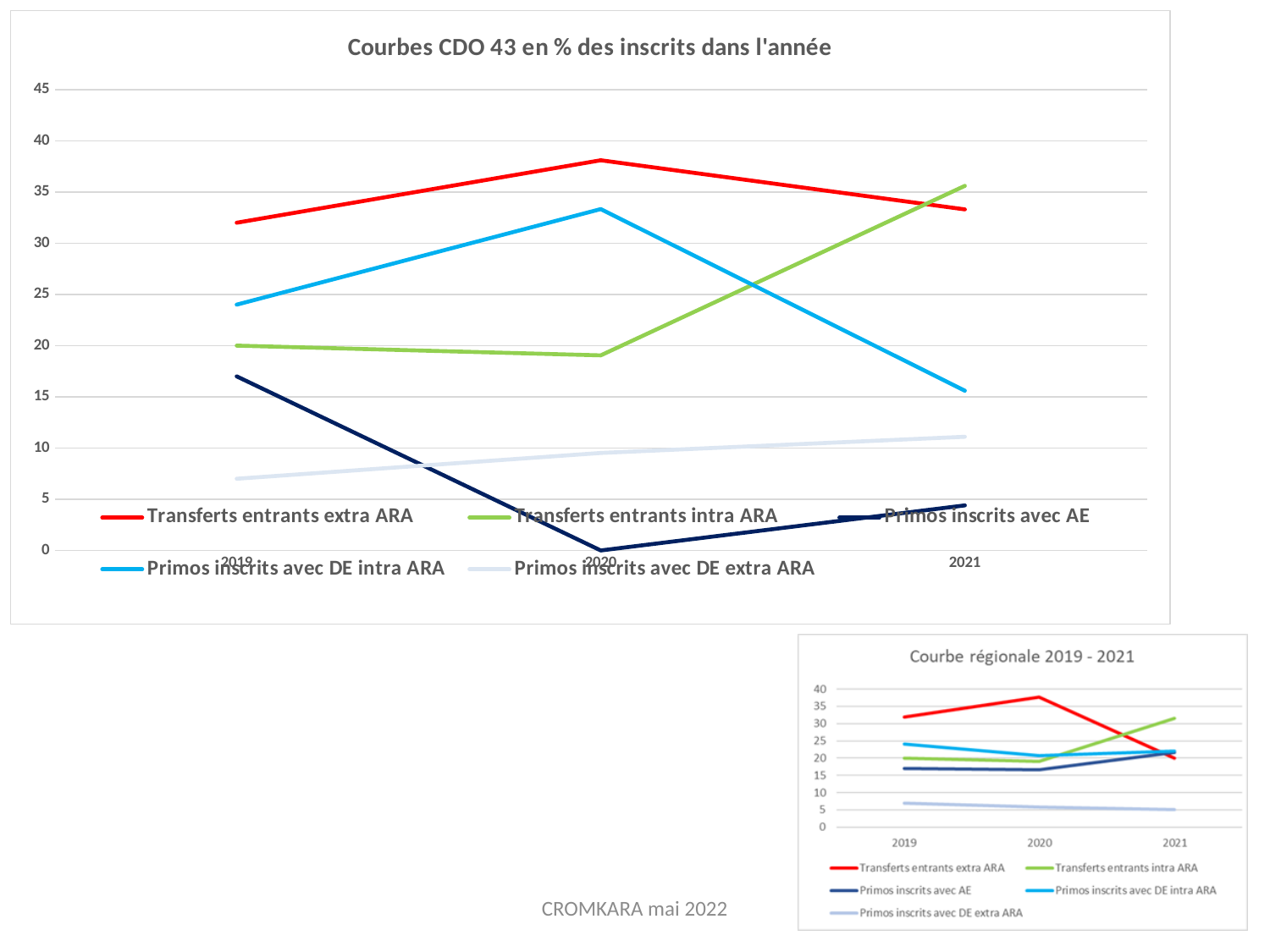
How many series does the legend of 'Courbes CDO 43 en % des inscrits dans l'année' list? 5 In 'Courbes CDO 43 en % des inscrits dans l'année', is the value for Primos inscrits avec DE intra ARA in 2021 greater or less than 20? less What kind of chart is 'Courbes CDO 43 en % des inscrits dans l'année'? line chart What is the title of the smaller chart at the bottom right of the slide? Courbe régionale 2019 - 2021 In 'Courbe régionale 2019 - 2021', which series has the highest value in 2020? Transferts entrants extra ARA In 'Courbes CDO 43 en % des inscrits dans l'année', which series has the highest value in 2020? Transferts entrants extra ARA In 'Courbes CDO 43 en % des inscrits dans l'année', which series has the lowest value in 2020? Primos inscrits avec AE How many years are plotted on the x axis of 'Courbes CDO 43 en % des inscrits dans l'année'? 3 In 'Courbes CDO 43 en % des inscrits dans l'année', does the Primos inscrits avec DE extra ARA line rise or fall from 2019 to 2021? rise In 'Courbes CDO 43 en % des inscrits dans l'année', is the value for Transferts entrants extra ARA in 2020 greater or less than 35? greater In 'Courbe régionale 2019 - 2021', is the value for Transferts entrants extra ARA in 2021 greater or less than 25? less In 'Courbes CDO 43 en % des inscrits dans l'année', which is larger in 2021: Transferts entrants intra ARA or Primos inscrits avec DE intra ARA? Transferts entrants intra ARA